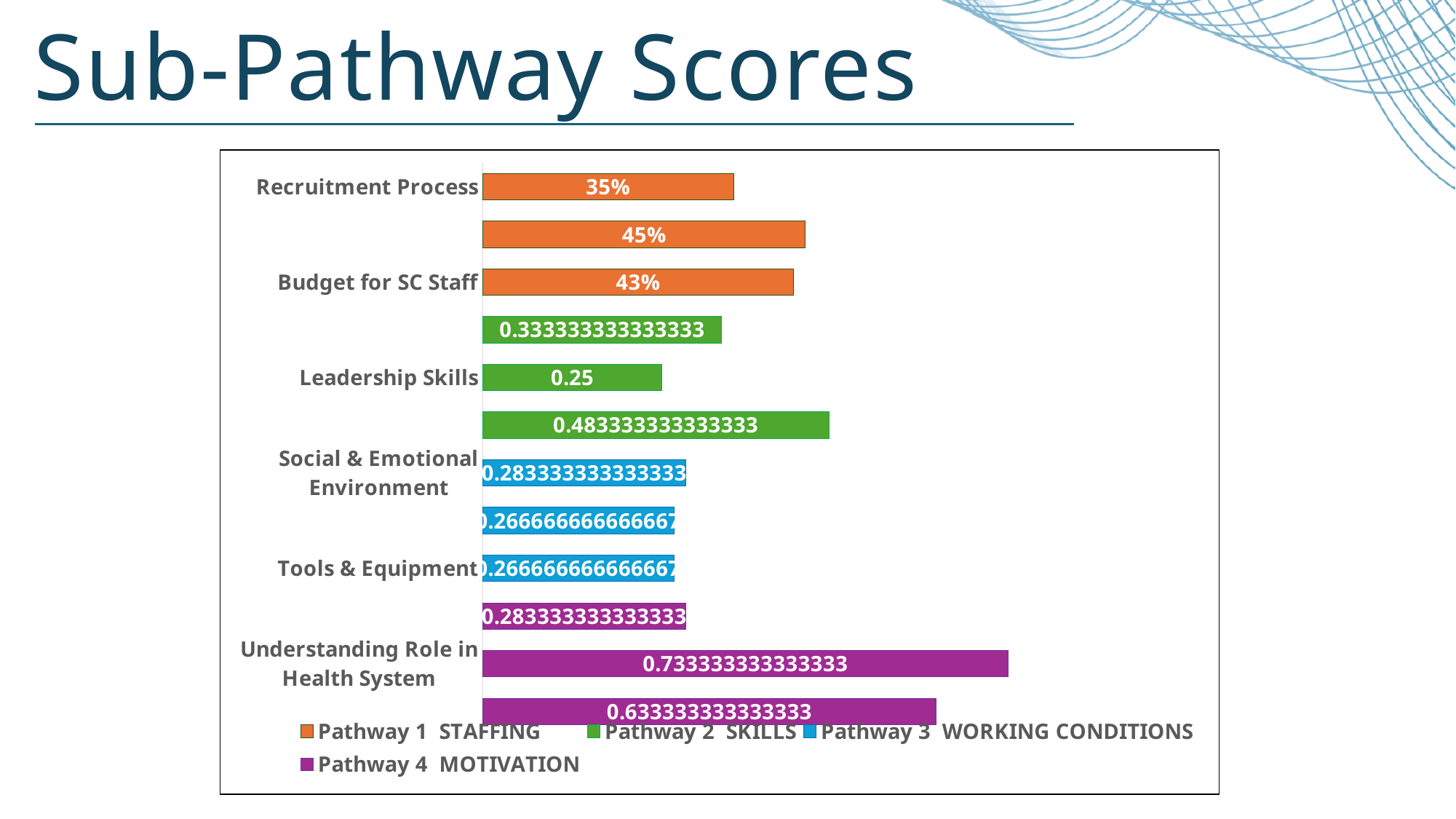
Which labelled category has the shortest bar? Leadership Skills What kind of chart is shown on the slide? Bar chart Which is larger, the value for Recruitment Process or the value for Budget for SC Staff? Budget for SC Staff How many series does the legend list? 4 What is the value for Budget for SC Staff? 43% What is the difference between the values for Budget for SC Staff and Recruitment Process? 8% Which labelled category has the longest bar? Understanding Role in Health System What is the value for Tools & Equipment? 0.266666666666667 What is the value for Understanding Role in Health System? 0.733333333333333 What is the value for Recruitment Process? 35% Which colour represents Pathway 4 MOTIVATION in the legend? Purple What is the value for Leadership Skills? 0.25